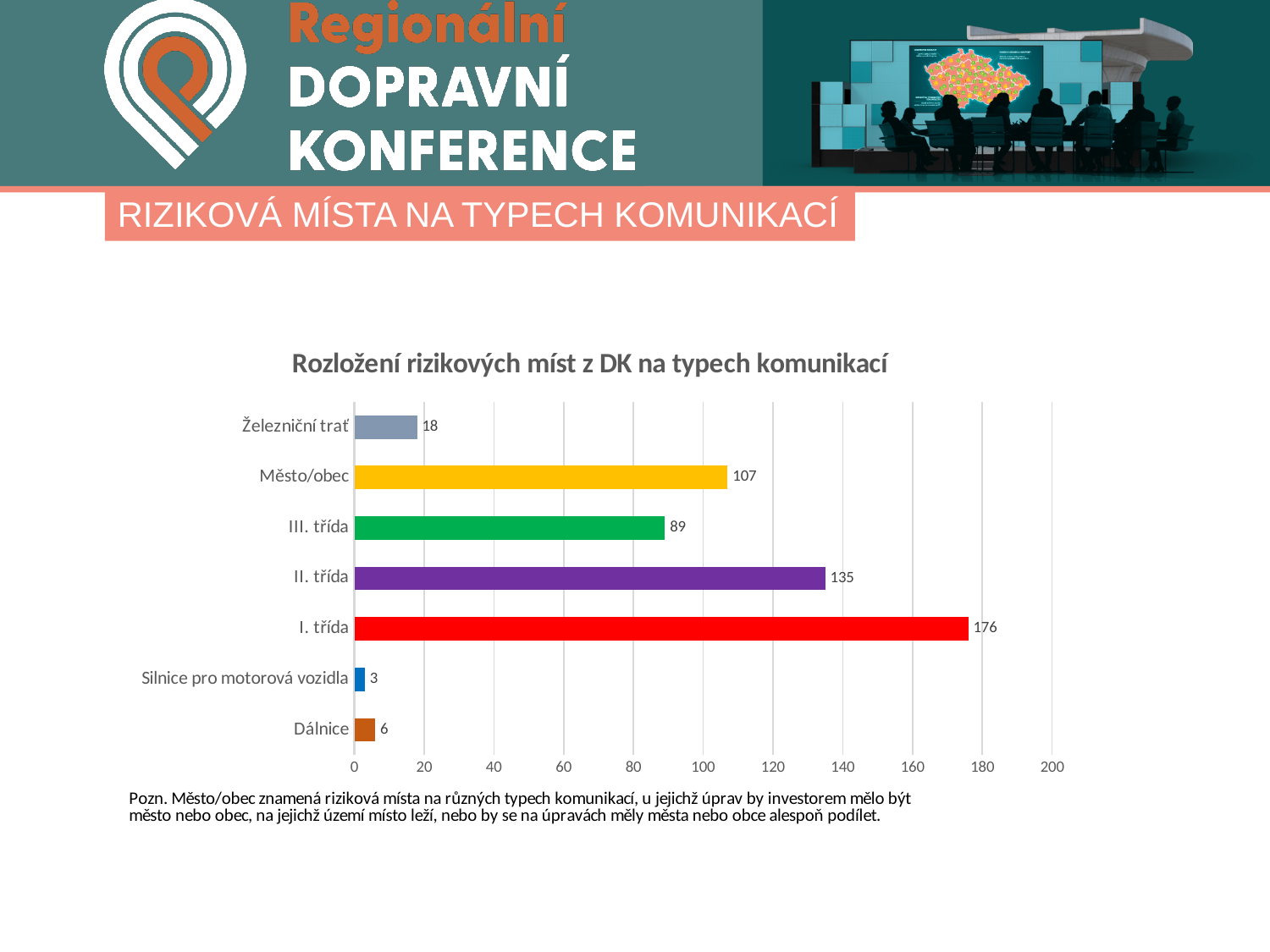
What is the value for Železniční trať? 18 Which category has the highest value? I. třída Which category has the lowest value? Silnice pro motorová vozidla Which is larger, the value for II. třída or the value for Město/obec? II. třída How many categories are shown in the chart? 7 What is the difference between the values for Město/obec and III. třída? 18 What is the value for I. třída? 176 What is the title of the chart? Rozložení rizikových míst z DK na typech komunikací What is the value for Město/obec? 107 Is the value for III. třída greater or less than 100? less What is the difference between the values for I. třída and II. třída? 41 What kind of chart is shown on the slide? bar chart